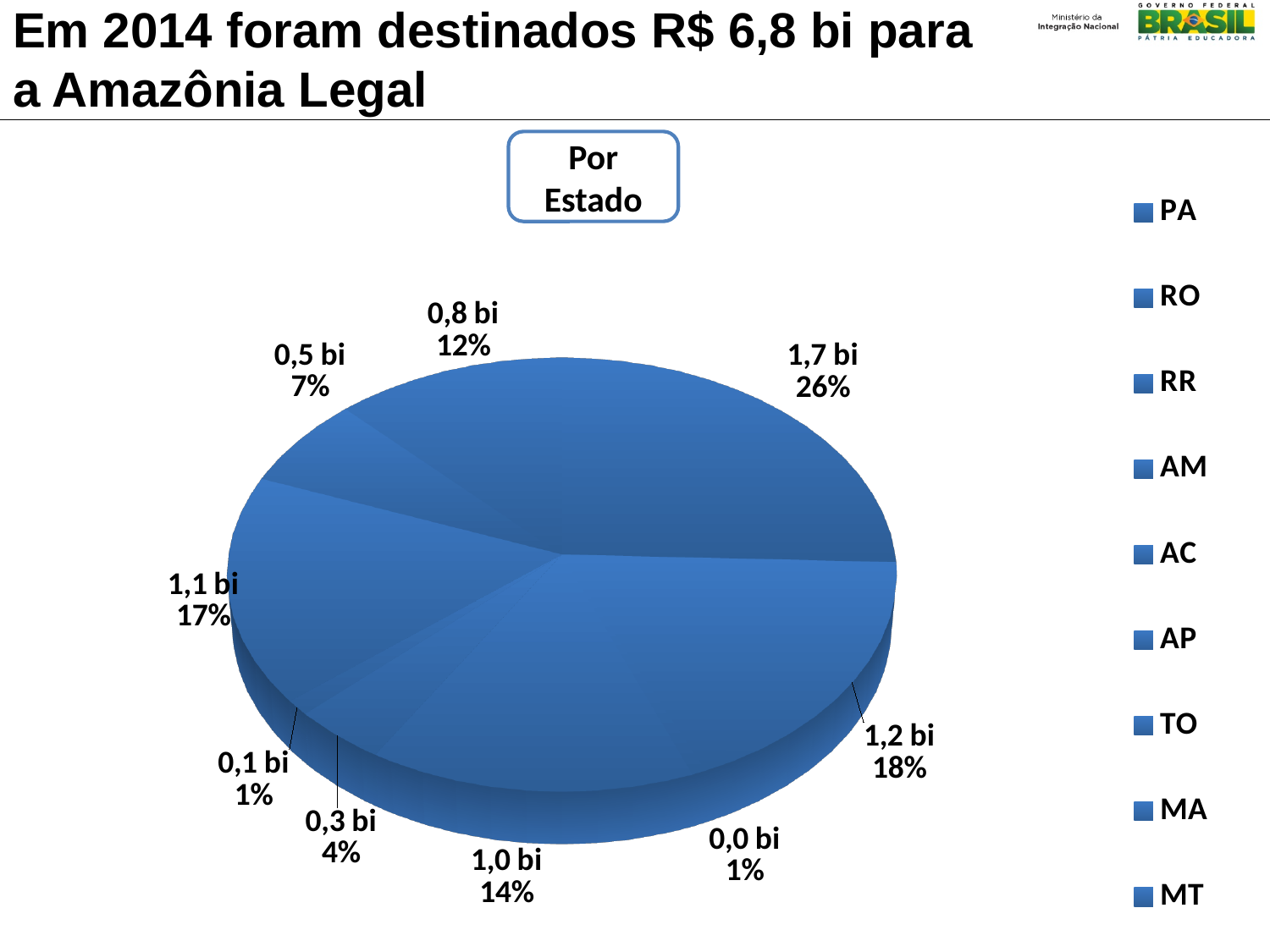
What is the difference in percentage points between the 26% slice and the 18% slice? 8 What value in bi is labelled on the slice with a 14% share? 1,0 bi How many entries does the legend of the pie chart list? 9 What is the smallest value in bi labelled on the pie chart? 0,0 bi What label appears in the box above the pie chart? Por Estado What is the first entry listed in the legend of the pie chart? PA How many slices does the pie chart have? 9 What value in bi is labelled on the largest slice of the pie chart? 1,7 bi Which slice is larger: the one labelled 1,1 bi or the one labelled 1,0 bi? 1,1 bi What kind of chart is shown on the slide? Pie chart What is the largest share shown on the pie chart? 26% What percentage share is labelled on the slice with the value 1,2 bi? 18%